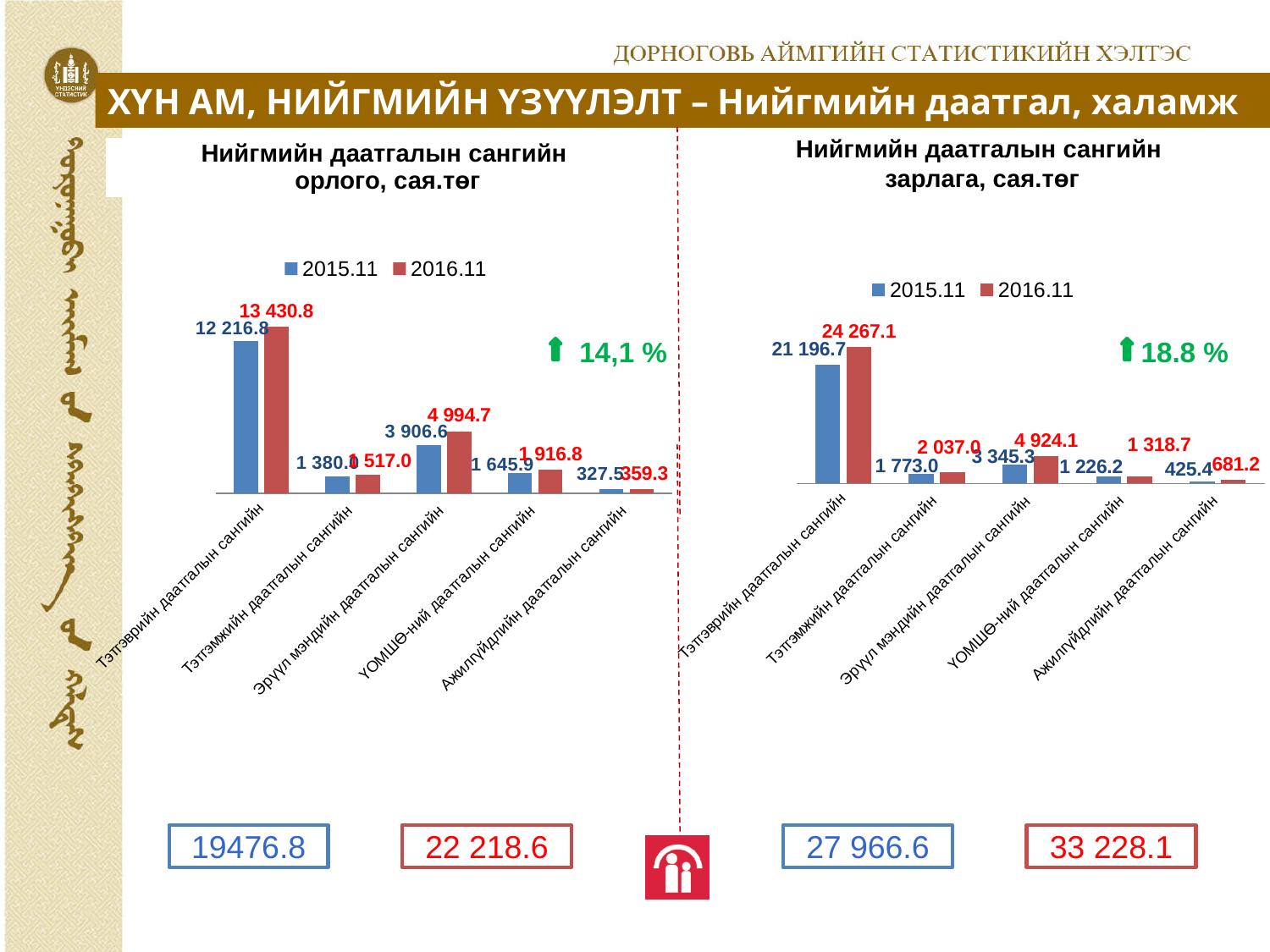
In the left chart (Нийгмийн даатгалын сангийн орлого), what is the 2016.11 value for Тэтгэврийн даатгалын сангийн? 13 430.8 In the right chart (Нийгмийн даатгалын сангийн зарлага), which category has the highest 2016.11 value? Тэтгэврийн даатгалын сангийн In the left chart (Нийгмийн даатгалын сангийн орлого), what is the difference between the 2016.11 and 2015.11 values for ҮОМШӨ-ний даатгалын сангийн? 270.9 What type of chart is the left chart (Нийгмийн даатгалын сангийн орлого)? Bar chart How many categories are shown on the x axis of the right chart (Нийгмийн даатгалын сангийн зарлага)? 5 In the right chart (Нийгмийн даатгалын сангийн зарлага), which is larger for Эрүүл мэндийн даатгалын сангийн: the 2015.11 value or the 2016.11 value? 2016.11 In the right chart (Нийгмийн даатгалын сангийн зарлага), what is the 2015.11 value for Тэтгэврийн даатгалын сангийн? 21 196.7 In the right chart (Нийгмийн даатгалын сангийн зарлага), what is the 2016.11 value for Ажилгүйдлийн даатгалын сангийн? 681.2 In the right chart (Нийгмийн даатгалын сангийн зарлага), what is the difference between the 2016.11 and 2015.11 values for Тэтгэврийн даатгалын сангийн? 3 070.4 In the left chart (Нийгмийн даатгалын сангийн орлого), how many series does the legend list? 2 In the left chart (Нийгмийн даатгалын сангийн орлого), which category has the lowest 2016.11 value? Ажилгүйдлийн даатгалын сангийн In the left chart (Нийгмийн даатгалын сангийн орлого), what is the 2015.11 value for Эрүүл мэндийн даатгалын сангийн? 3 906.6